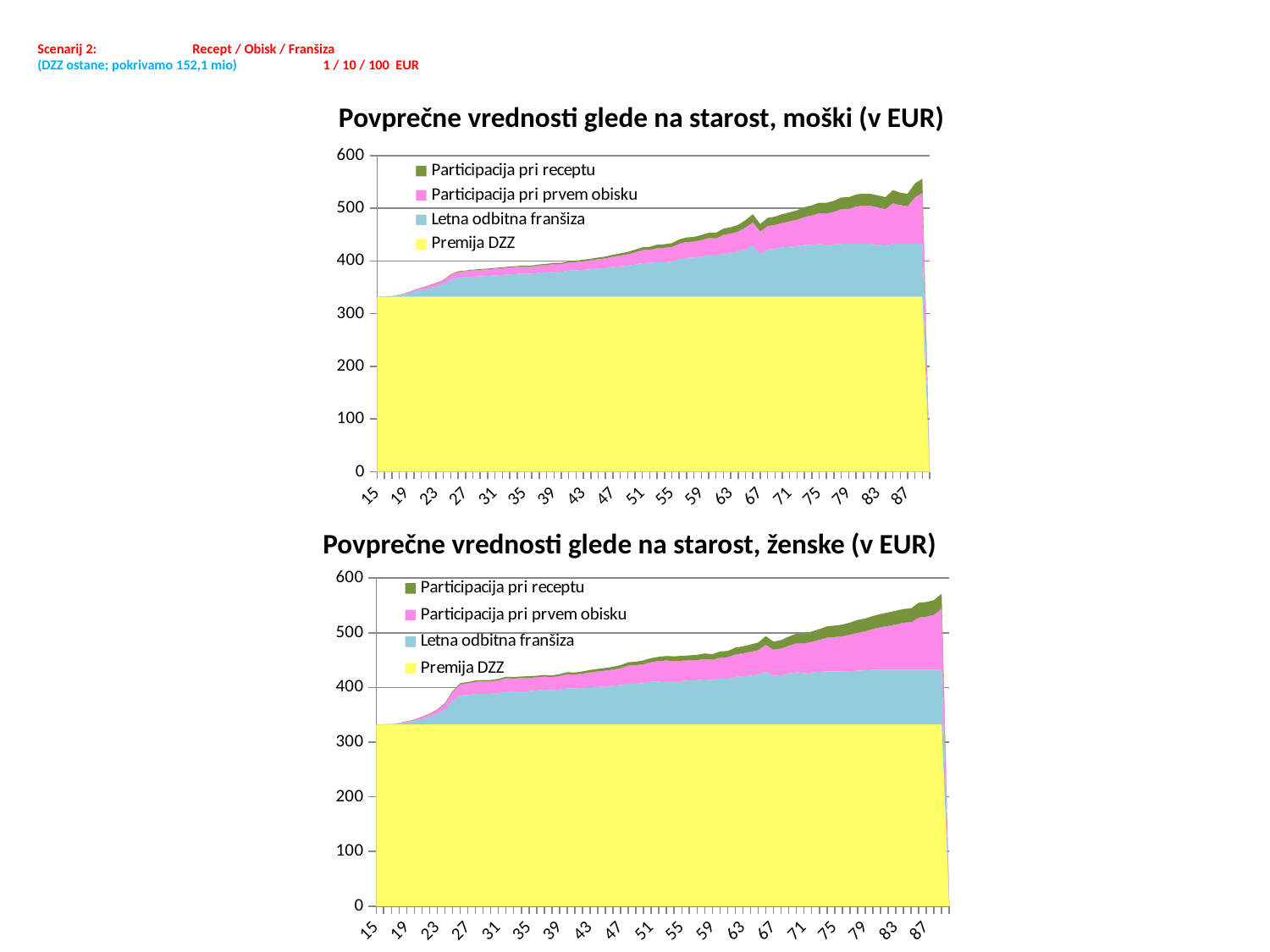
In the top chart (moški), is the total stacked value at age 87 greater or less than 500? greater In the bottom chart (ženske), which series is listed first in the legend? Participacija pri receptu What is the highest value shown on the y axis of the top chart (moški)? 600 How many series does the legend of the bottom chart, 'Povprečne vrednosti glede na starost, ženske (v EUR)', list? 4 In the bottom chart (ženske), is the value for Premija DZZ at age 50 greater or less than 400? less What kind of chart is the top chart, 'Povprečne vrednosti glede na starost, moški (v EUR)'? Stacked area chart In the bottom chart (ženske), is the total stacked value at age 87 greater or less than 500? greater In the top chart (moški), which series is shown in yellow? Premija DZZ In the bottom chart (ženske), does the total stacked value rise or fall as age increases from 15 to 87? Rise In the top chart (moški), does the total stacked value rise or fall as age increases from 15 to 87? Rise